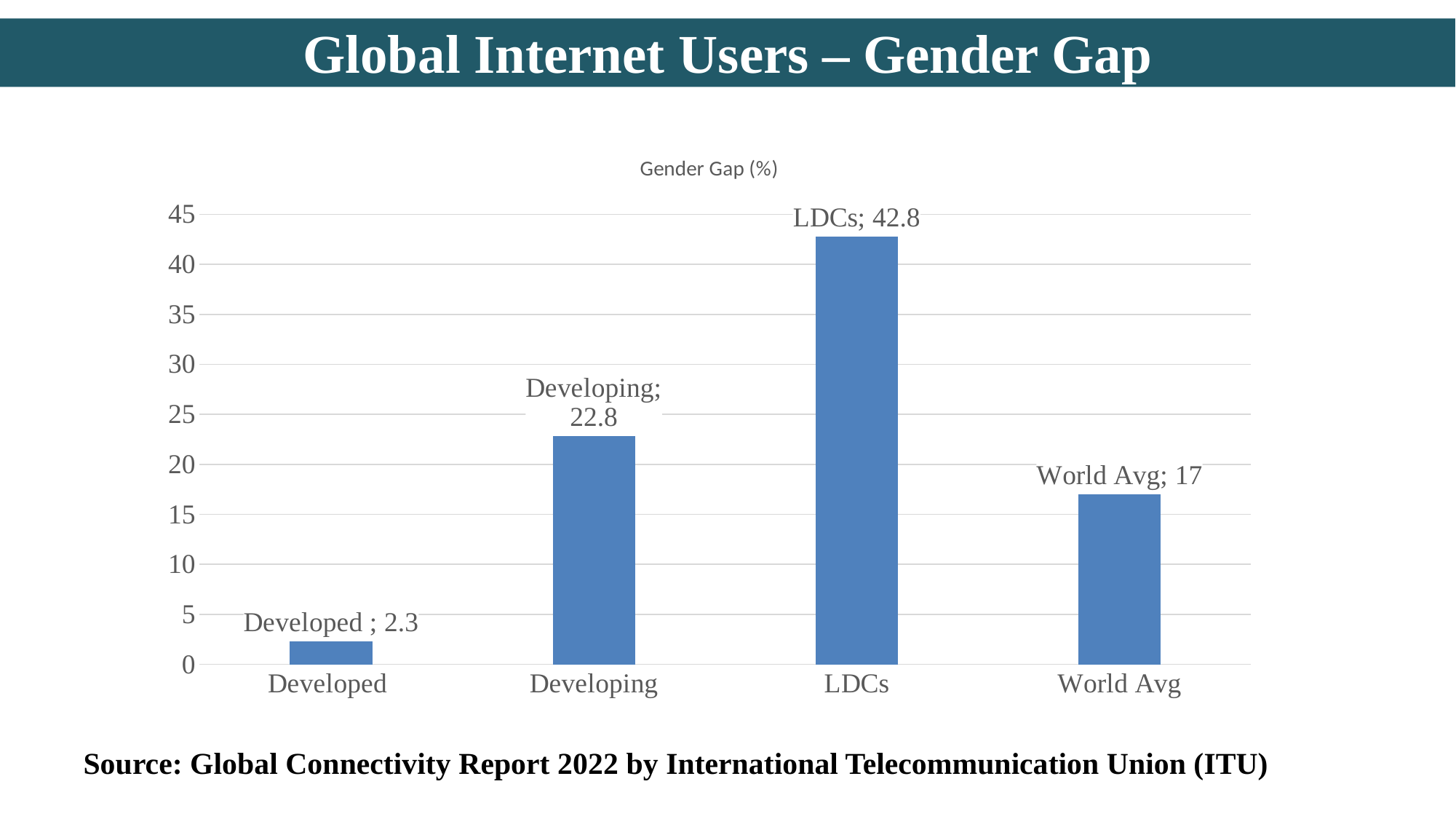
What is the gender gap value for LDCs? 42.8 Which category has the highest gender gap? LDCs What is the difference between the gender gap for Developing and World Avg? 5.8 What is the title of the chart? Gender Gap (%) What is the gender gap value for Developed? 2.3 How many categories are shown in the chart? 4 What is the gender gap value for Developing? 22.8 What is the difference between the gender gap for LDCs and Developing? 20 What kind of chart is shown on the slide? Bar chart Which category has the lowest gender gap? Developed What is the gender gap value for World Avg? 17 Which is larger, the gender gap for Developing or for World Avg? Developing